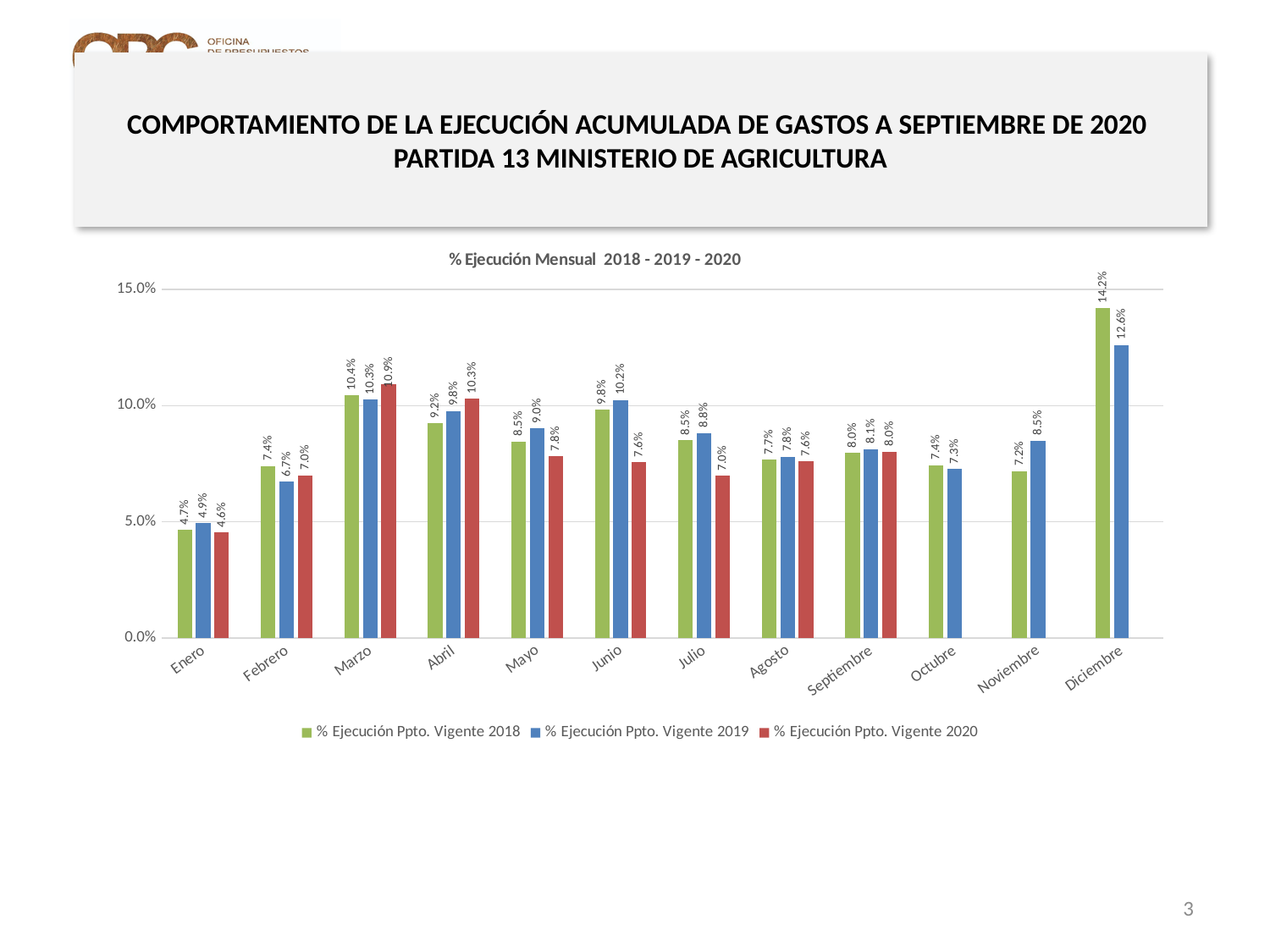
Is the value for % Ejecución Ppto. Vigente 2018 in Marzo greater or less than 10.0%? greater What is the value for % Ejecución Ppto. Vigente 2019 in Noviembre? 8.5% What is the title of the chart? % Ejecución Mensual 2018 - 2019 - 2020 Which is larger in Junio: the 2019 value or the 2020 value? 2019 value (10.2%) What kind of chart is shown on the slide? Bar chart What is the difference between the 2018 and 2019 values in Diciembre? 1.6% What is the value for % Ejecución Ppto. Vigente 2020 in Marzo? 10.9% What is the value for % Ejecución Ppto. Vigente 2018 in Diciembre? 14.2% How many series does the legend list? 3 How many months are shown on the x axis? 12 Which month has the lowest value for % Ejecución Ppto. Vigente 2020? Enero Which month has the highest value for % Ejecución Ppto. Vigente 2019? Diciembre